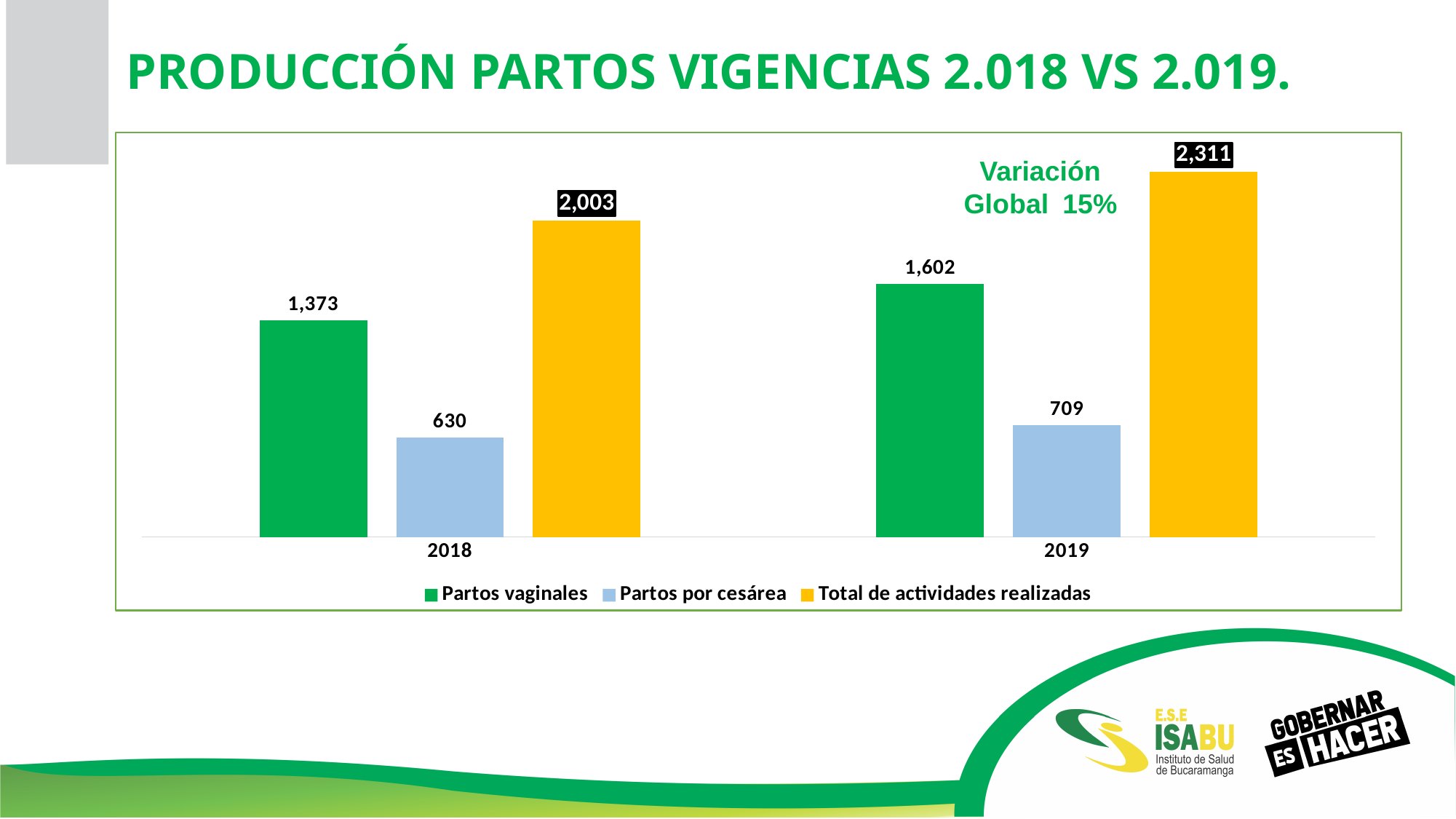
Which is larger: Partos por cesárea in 2018 or Partos por cesárea in 2019? Partos por cesárea in 2019 How many series does the legend list? 3 What is the value of Partos por cesárea in 2018? 630 Which series has the highest value in 2018? Total de actividades realizadas What is the value of Partos por cesárea in 2019? 709 What kind of chart is shown on the slide? Bar chart What is the value of Partos vaginales in 2018? 1,373 What is the difference between Partos vaginales in 2019 and in 2018? 229 Which series has the lowest value in 2019? Partos por cesárea What global variation percentage is stated on the chart? 15% What is the value of Total de actividades realizadas in 2019? 2,311 What is the difference between Total de actividades realizadas in 2019 and in 2018? 308